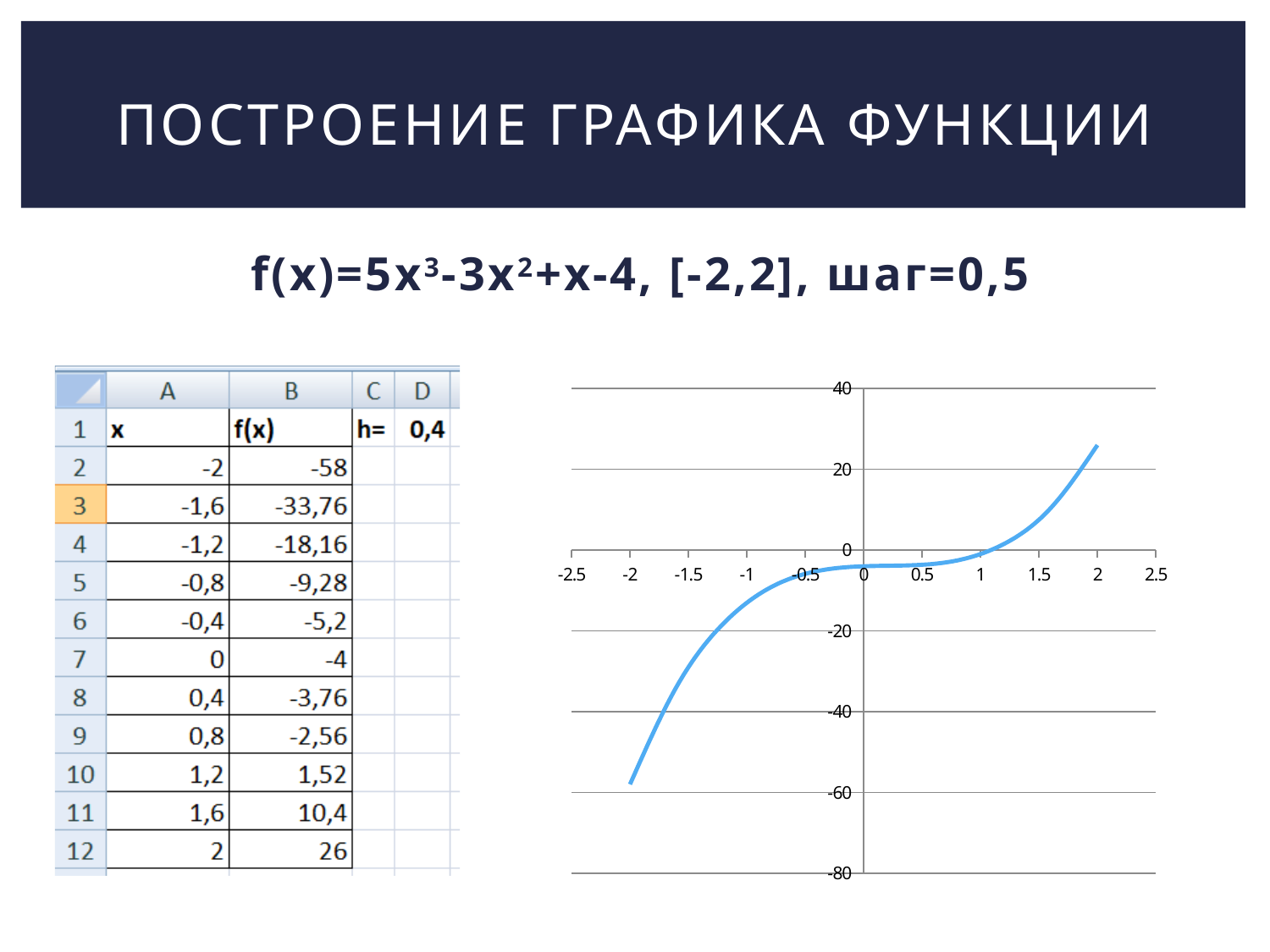
According to the table on the slide, what is f(x) at x = 2? 26 On the chart, is the value of the curve at x = 0 greater or less than 20? less Using the table values, what is the difference between f(2) and f(-2)? 84 Does the plotted curve rise or fall as x increases from -2 to 2? rise How many x values are listed in the table on the slide? 11 At which x value in the table is f(x) lowest? -2 According to the table on the slide, what is f(x) at x = 0? -4 What are the lowest and highest tick values on the chart's vertical axis? -80 and 40 On the chart, is the value of the curve at x = -2 greater or less than -40? less According to the table on the slide, what is f(x) at x = -2? -58 On the chart, is the value of the curve at x = 2 greater or less than 20? greater What kind of chart is shown on the right of the slide? line chart